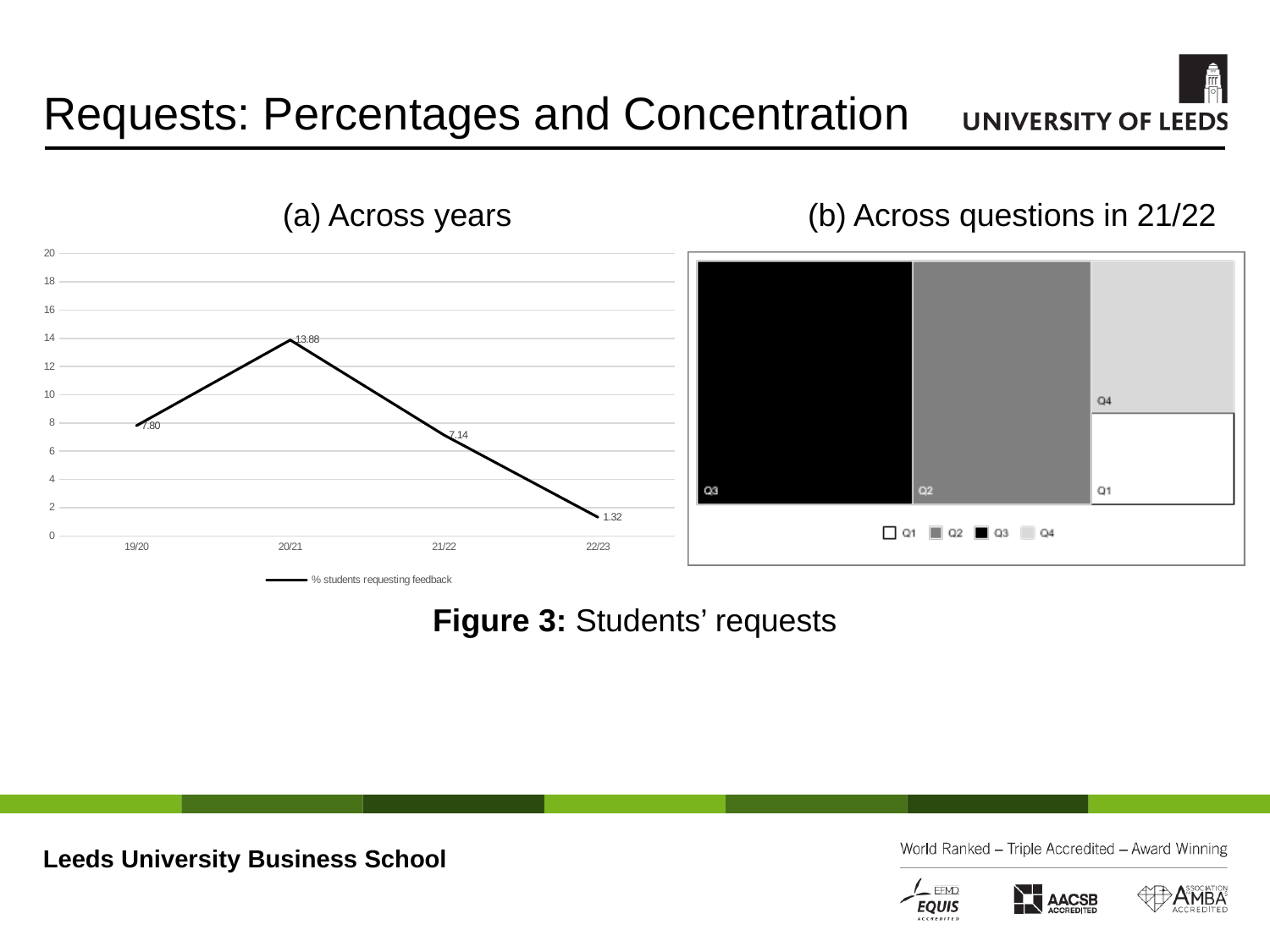
In chart (a) Across years, what is the value for 22/23? 1.32 In chart (a) Across years, which year has the lowest percentage of students requesting feedback? 22/23 In chart (a) Across years, do the values rise or fall from 20/21 to 22/23? Fall What kind of chart is chart (a) Across years? Line chart In chart (b) Across questions in 21/22, which question occupies the largest area? Q3 In chart (a) Across years, which year has the highest percentage of students requesting feedback? 20/21 In chart (a) Across years, what is the value for 19/20? 7.80 In chart (a) Across years, what is the value for 20/21? 13.88 In chart (b) Across questions in 21/22, how many entries does the legend list? 4 In chart (a) Across years, what is the difference between the values for 20/21 and 21/22? 6.74 In chart (a) Across years, how many years are plotted on the x axis? 4 In chart (a) Across years, which is larger, the value for 19/20 or the value for 21/22? 19/20